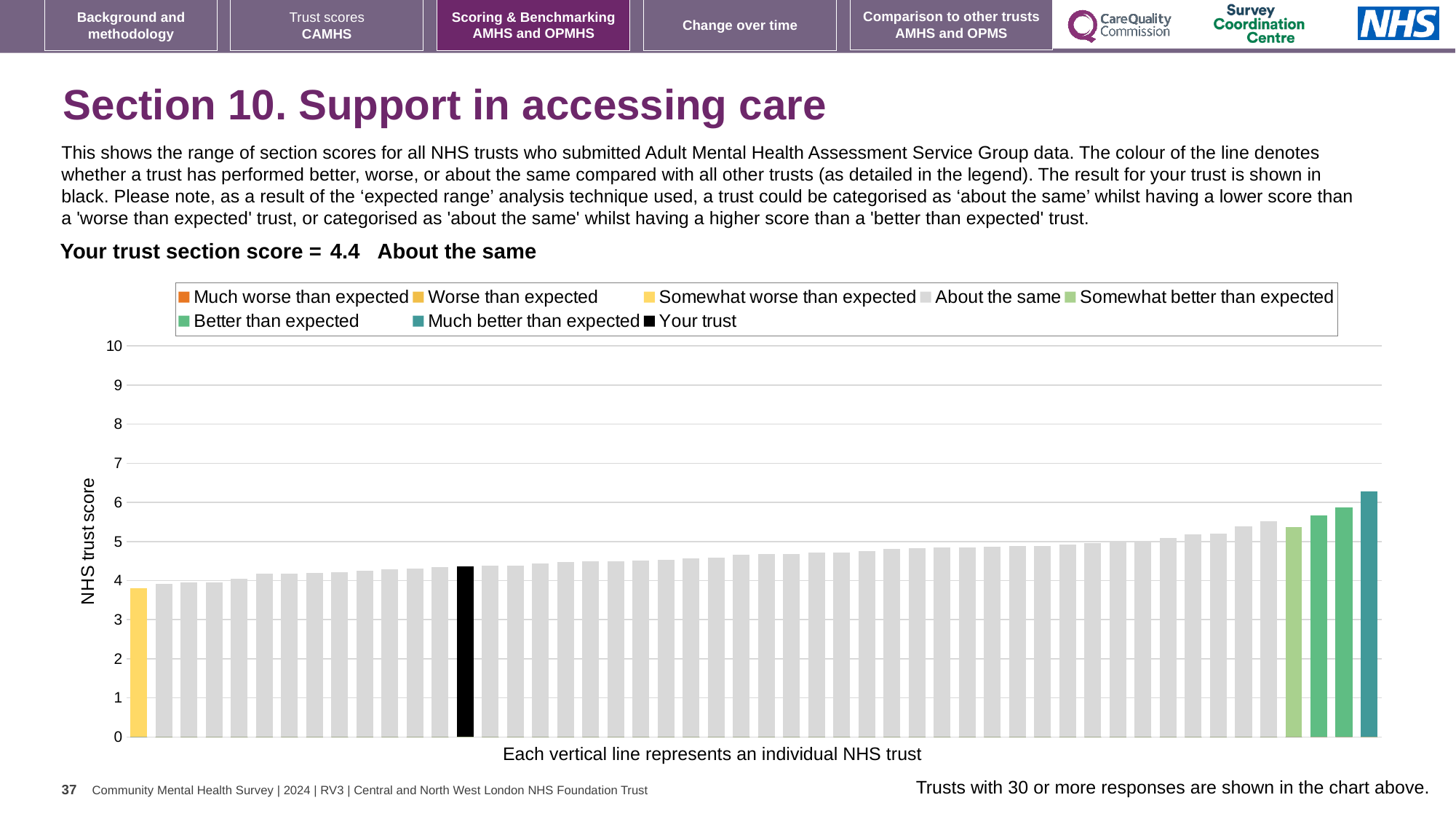
Which legend category does the shortest bar belong to? Somewhat worse than expected How many entries does the chart legend list? 8 What kind of chart is shown on the slide? bar chart What is the label on the y axis of the chart? NHS trust score What is the section score for your trust? 4.4 Is the value for your trust greater or less than 5? less Is the value of the tallest bar greater or less than 6? greater Which legend category does the tallest bar belong to? Much better than expected Is the value of the shortest bar greater or less than 4? less Do the bar values rise or fall from left to right along the x axis? rise How many trusts are shown as 'Much better than expected'? 1 Which category is your trust placed in for this section? About the same